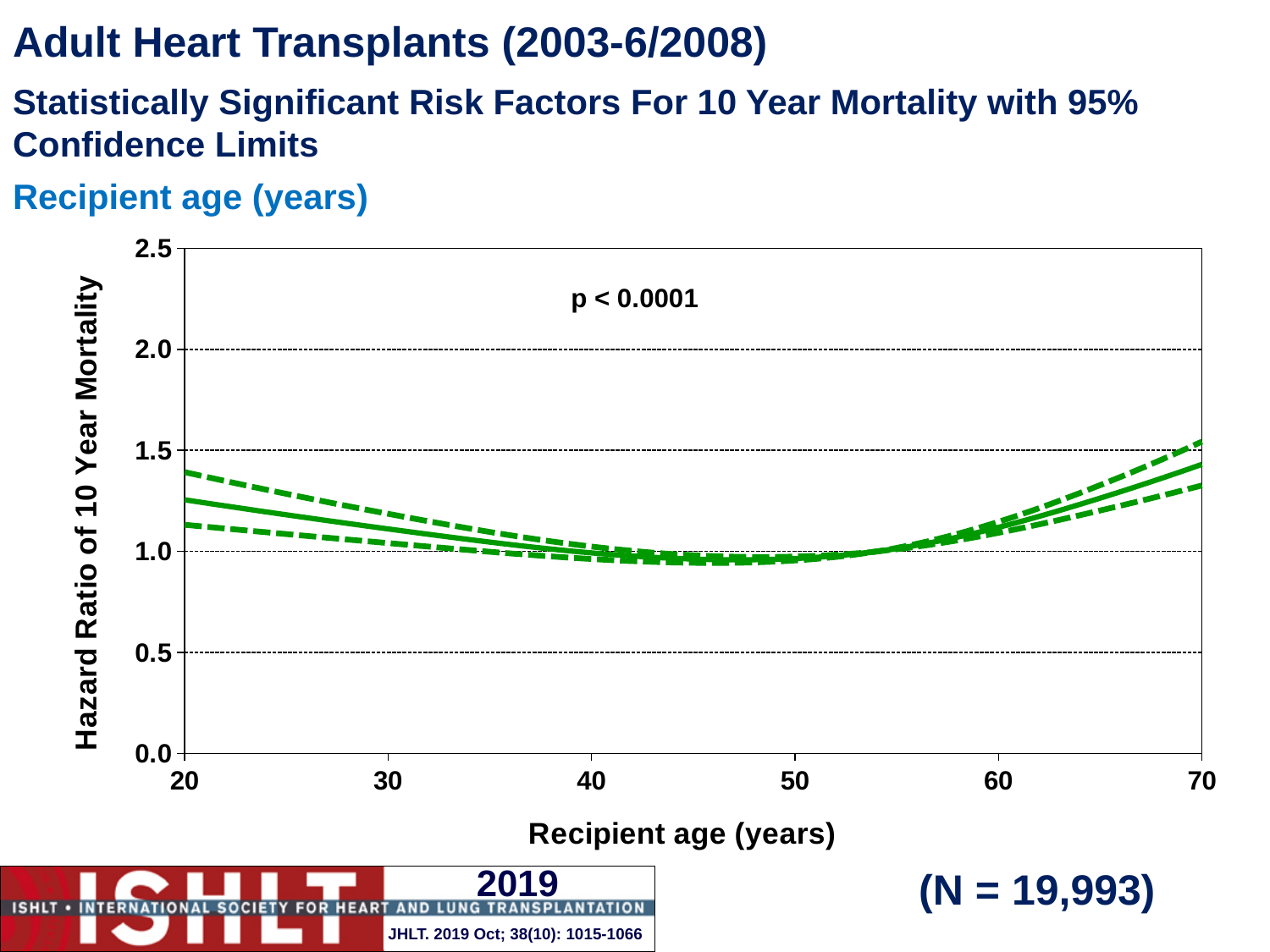
Is the hazard ratio (solid line) at recipient age 70 greater or less than 1.5? less How many lines are plotted on the chart? 3 What is the label of the x axis? Recipient age (years) Is the hazard ratio (solid line) at recipient age 45 greater or less than 1.0? less Which has the higher hazard ratio on the solid line: recipient age 20 or recipient age 70? 70 How does the hazard ratio (solid line) change as recipient age increases from 20 to 45? falls Is the hazard ratio (solid line) at recipient age 70 greater or less than 1.0? greater What is the label of the y axis? Hazard Ratio of 10 Year Mortality How does the hazard ratio (solid line) change as recipient age increases from 50 to 70? rises What kind of chart is shown on the slide? line chart